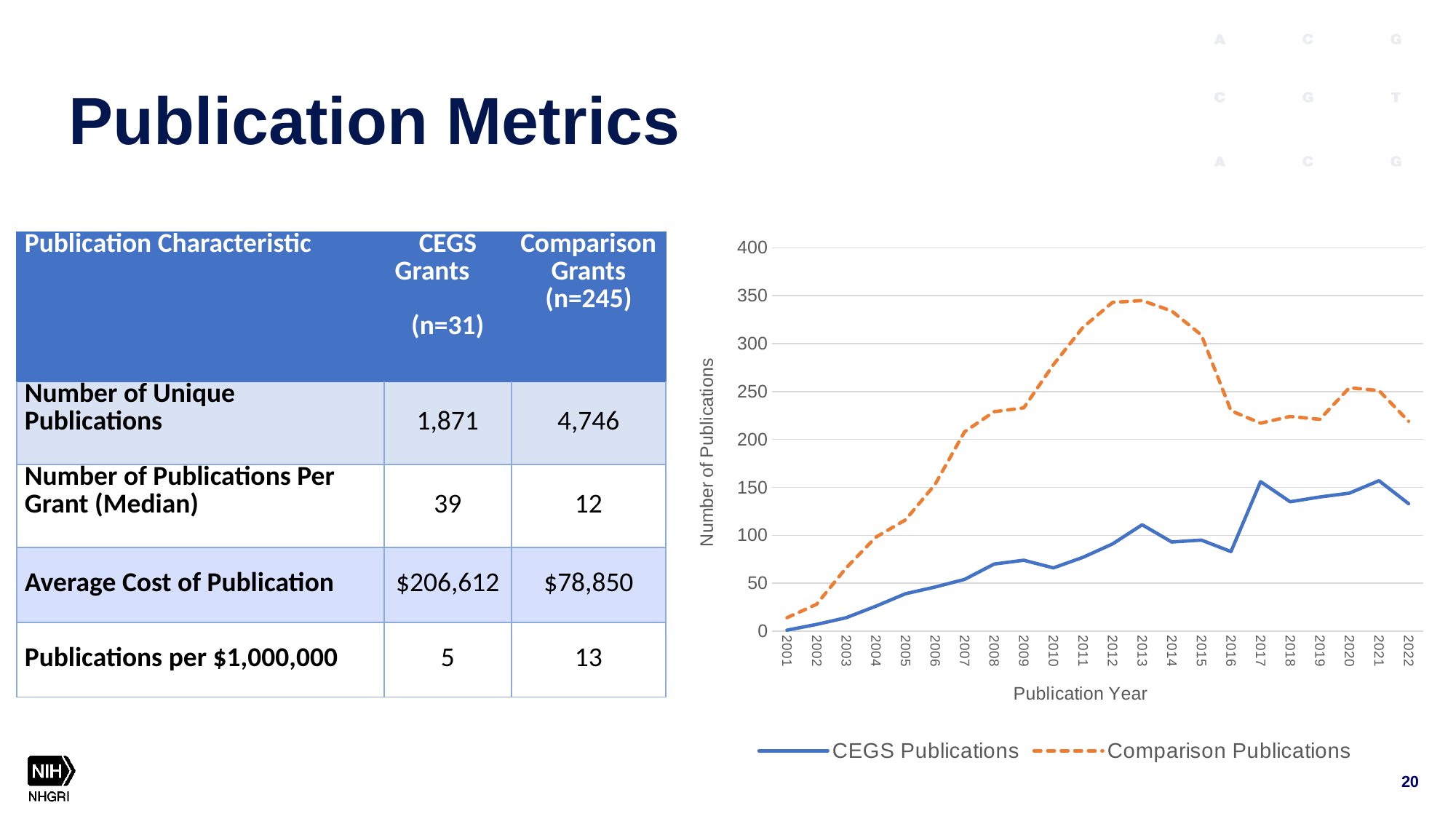
How many series does the chart legend list? 2 Is the value for CEGS Publications in 2022 greater or less than 100? greater Does the CEGS Publications line generally rise or fall from 2001 to 2013? rise In which year does the Comparison Publications line reach its highest value? 2013 In which year is the CEGS Publications line at its lowest value? 2001 Is the value for Comparison Publications in 2013 greater or less than 300? greater Is the value for Comparison Publications in 2022 greater or less than 250? less In 2013, which series has the larger value, CEGS Publications or Comparison Publications? Comparison Publications How many publication years are plotted along the x axis of the chart? 22 What kind of chart is shown on the slide? line chart What is the label on the vertical axis of the chart? Number of Publications